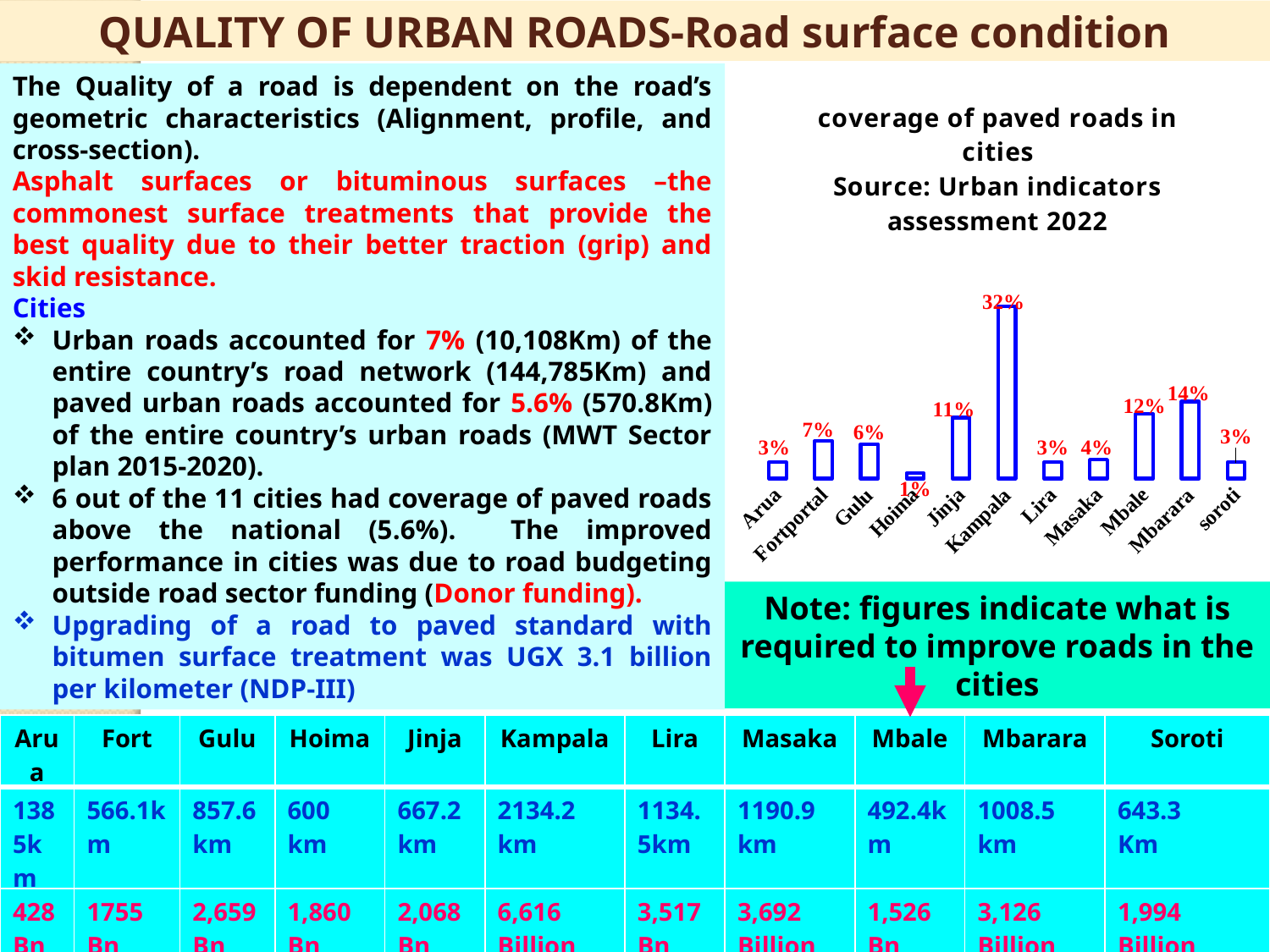
What is the coverage of paved roads for Mbarara? 14% What is the difference in paved road coverage between Mbale and Masaka? 8% What is the coverage of paved roads for Jinja? 11% How many cities are shown in the chart? 11 What is the difference in paved road coverage between Kampala and Mbarara? 18% What is the coverage of paved roads for Kampala? 32% What is the source cited for the chart data? Urban indicators assessment 2022 What is the coverage of paved roads for Hoima? 1% Which city has the highest coverage of paved roads? Kampala What type of chart is used to show coverage of paved roads in cities? Bar chart Which has a higher coverage of paved roads, Fortportal or Gulu? Fortportal Which city has the lowest coverage of paved roads? Hoima